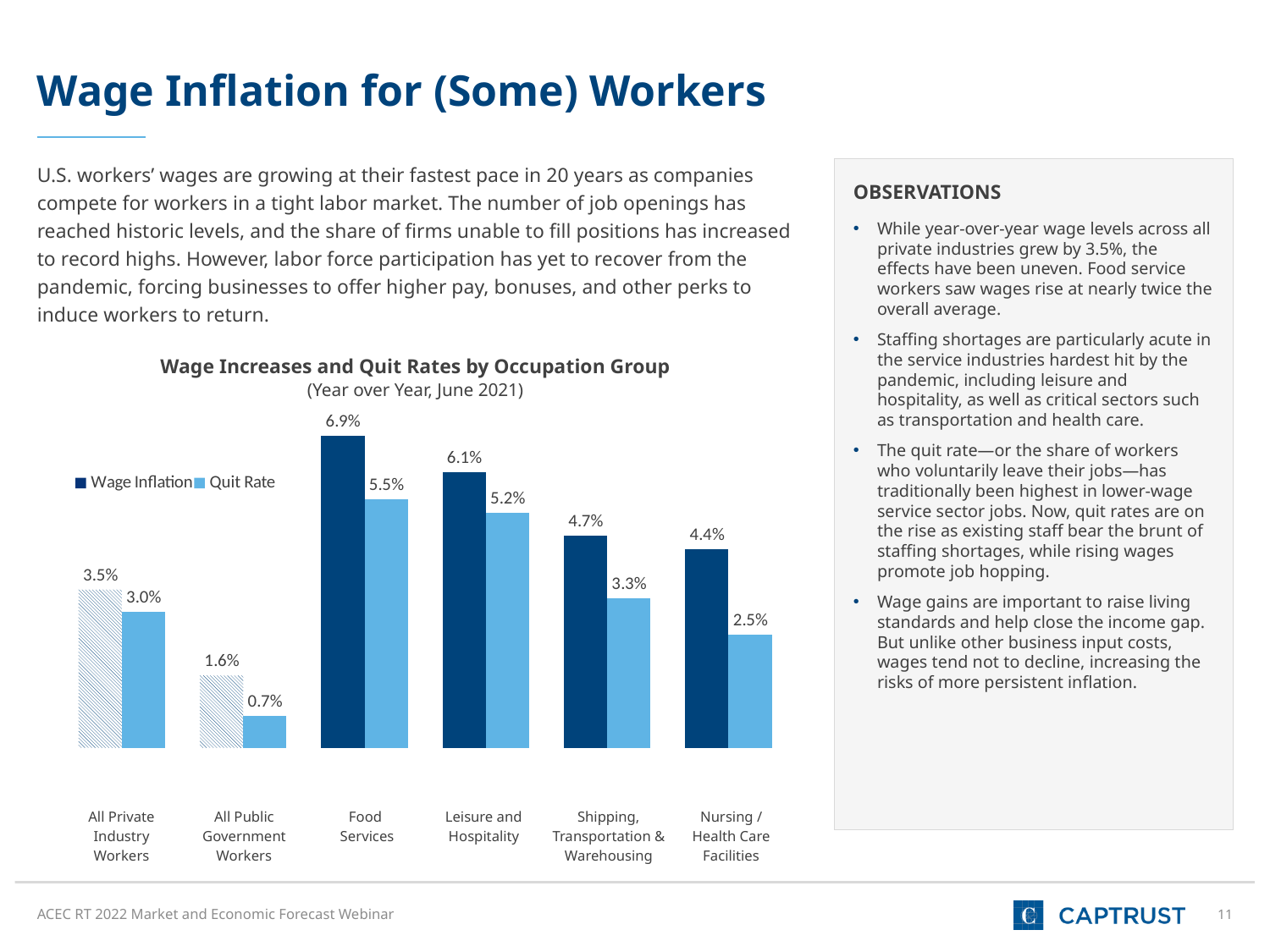
What kind of chart is shown on the slide? Bar chart What is the title of the chart? Wage Increases and Quit Rates by Occupation Group How many occupation groups are shown on the chart? 6 Which occupation group has the highest Wage Inflation? Food Services What is the Quit Rate for All Public Government Workers? 0.7% What is the difference between Wage Inflation and Quit Rate for Nursing / Health Care Facilities? 1.9% How many series does the legend list? 2 What is the difference in Wage Inflation between Food Services and All Private Industry Workers? 3.4% Which occupation group has the lowest Quit Rate? All Public Government Workers Which is larger for Leisure and Hospitality: Wage Inflation or Quit Rate? Wage Inflation What is the Quit Rate for Nursing / Health Care Facilities? 2.5% What is the Wage Inflation value for Food Services? 6.9%